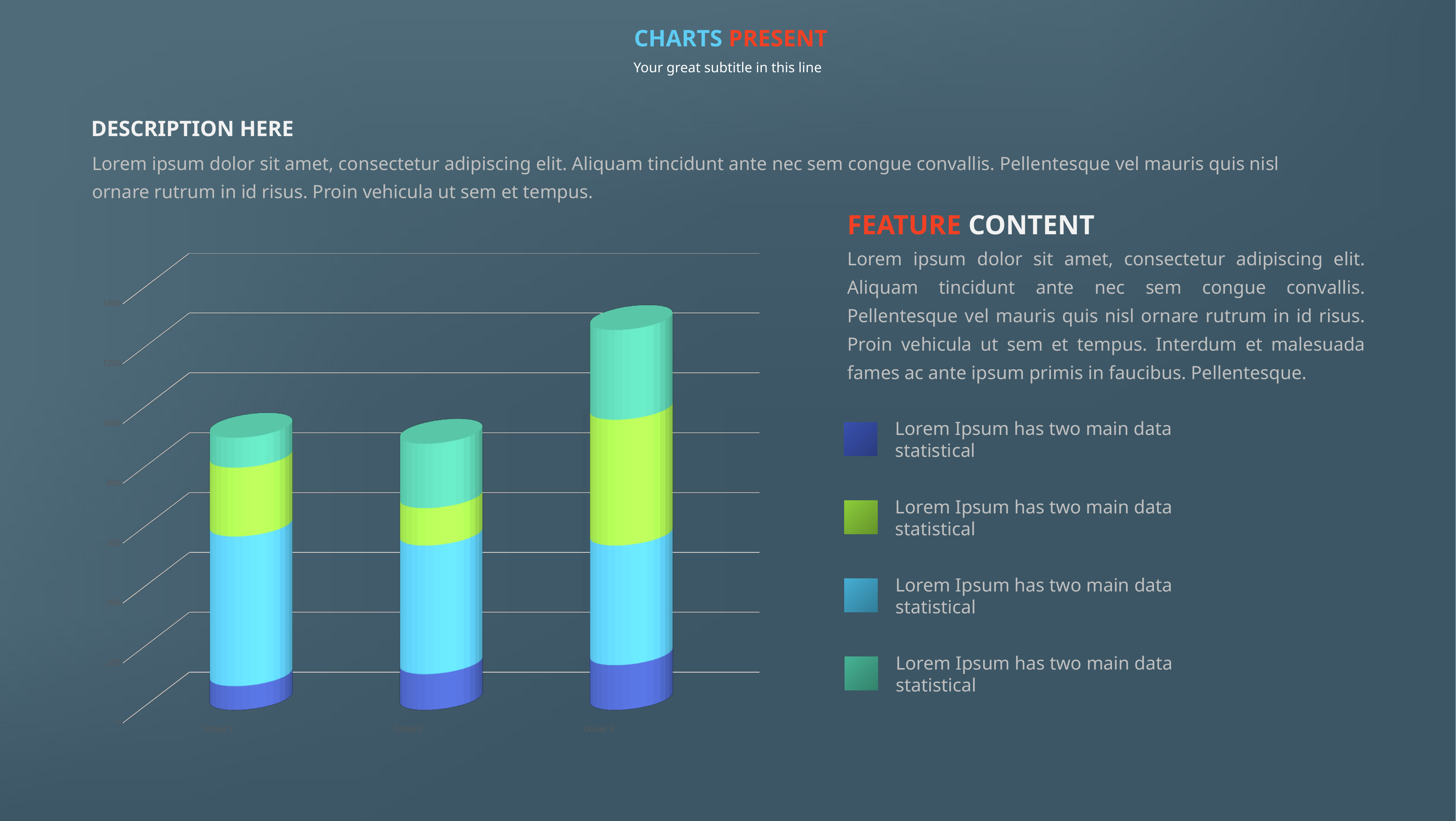
Which group has the tallest stacked bar in the chart? Group 3 Which stacked bar is taller, Group 3 or Group 1? Group 3 What is the highest value shown on the chart's vertical axis? 1400 How many categories (groups) are plotted on the x axis of the chart? 3 Which stacked bar is taller, Group 3 or Group 2? Group 3 Is the total value for Group 1 greater or less than 1200? less How many series does the legend on the right of the chart list? 4 What colour is the bottom segment of each stacked bar in the chart? Dark blue Is the total value for Group 2 greater or less than 1200? less What kind of chart is shown on the slide? Stacked bar chart Is the total value for Group 3 greater or less than 1000? greater